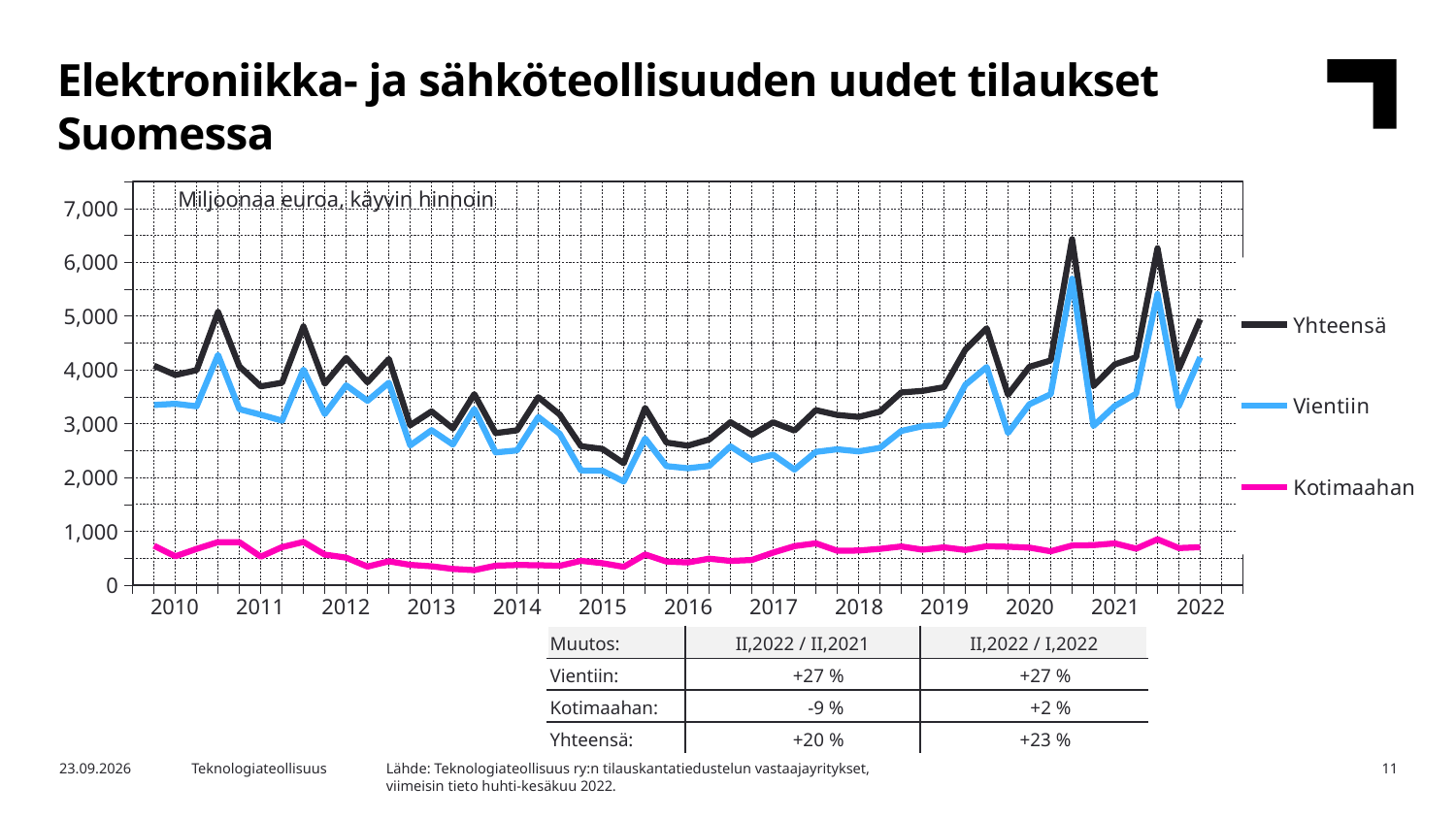
Is the peak value for Yhteensä in 2020 greater or less than 6,000? greater In 2018, which is larger, Vientiin or Kotimaahan? Vientiin Is the value for Vientiin at the start of 2015 greater or less than 3,000? less What kind of chart is shown on the slide? Line chart Is the peak value for Vientiin in 2020 greater or less than 5,000? greater Which series is plotted with the lowest values throughout the chart? Kotimaahan How many series does the legend list? 3 How many year labels are shown on the x axis? 13 Does the Yhteensä line generally rise or fall from 2016 to 2019? rise Which series is plotted with the highest values throughout the chart? Yhteensä What unit label is shown at the top of the chart area? Miljoonaa euroa, käyvin hinnoin